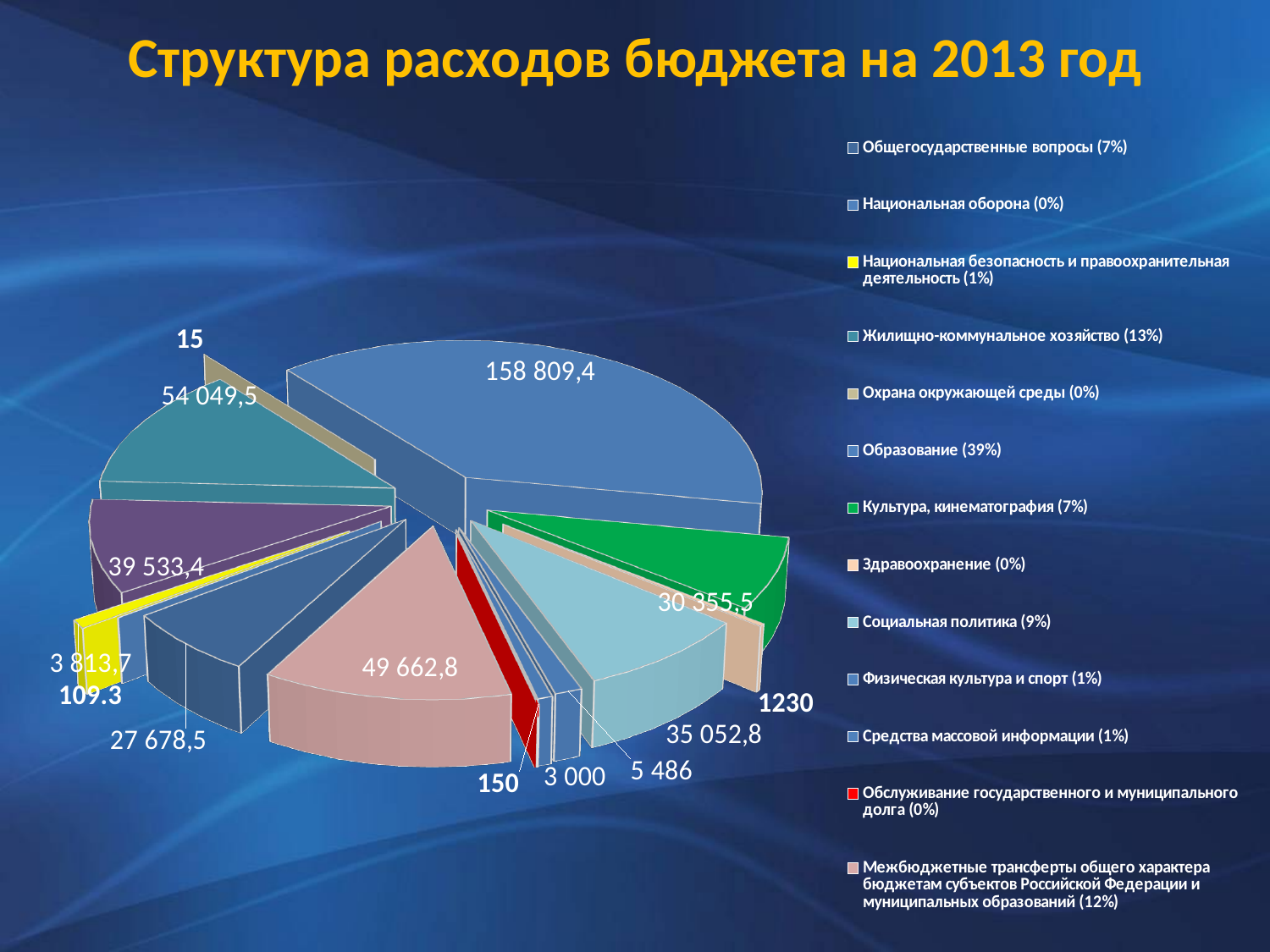
What share of the pie does Социальная политика represent according to the legend? 9% Which has the larger share, Образование or Жилищно-коммунальное хозяйство? Образование What is the smallest value labelled on the pie chart? 15 What share of the pie does Жилищно-коммунальное хозяйство represent according to the legend? 13% What is the value of the largest slice, Образование? 158 809,4 By how many percentage points does the share of Образование (39%) exceed the share of Межбюджетные трансферты (12%)? 27% What share of the pie does Образование represent according to the legend? 39% How many categories does the legend list? 13 What is the largest value labelled on the pie chart? 158 809,4 What is the title of the chart? Структура расходов бюджета на 2013 год How many legend entries show a share of 0%? 4 What kind of chart is shown on the slide? pie chart